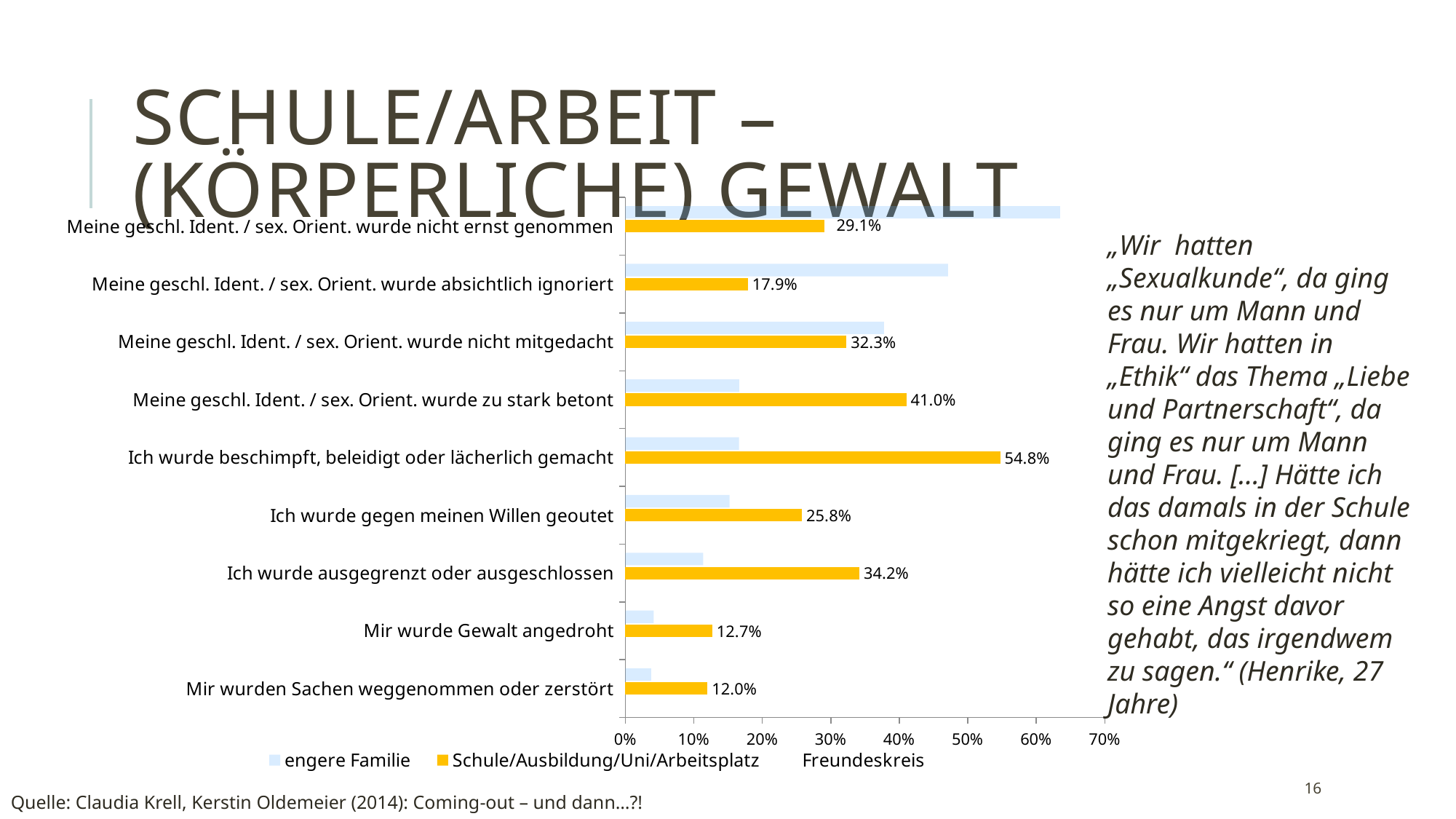
Is the 'engere Familie' value for 'Meine geschl. Ident. / sex. Orient. wurde nicht ernst genommen' greater or less than 60%? greater What is the value for 'Schule/Ausbildung/Uni/Arbeitsplatz' in the category 'Mir wurde Gewalt angedroht'? 12.7% Which category has the highest value for the 'Schule/Ausbildung/Uni/Arbeitsplatz' series? Ich wurde beschimpft, beleidigt oder lächerlich gemacht What kind of chart is shown on the slide? bar chart For the 'Schule/Ausbildung/Uni/Arbeitsplatz' series, which is larger: 'Ich wurde ausgegrenzt oder ausgeschlossen' or 'Ich wurde gegen meinen Willen geoutet'? Ich wurde ausgegrenzt oder ausgeschlossen What is the value for 'Schule/Ausbildung/Uni/Arbeitsplatz' in the category 'Meine geschl. Ident. / sex. Orient. wurde absichtlich ignoriert'? 17.9% Which category has the lowest value for the 'Schule/Ausbildung/Uni/Arbeitsplatz' series? Mir wurden Sachen weggenommen oder zerstört Is the 'engere Familie' value for 'Mir wurde Gewalt angedroht' greater or less than 10%? less What is the difference between the 'Schule/Ausbildung/Uni/Arbeitsplatz' values for 'Ich wurde beschimpft, beleidigt oder lächerlich gemacht' and 'Meine geschl. Ident. / sex. Orient. wurde zu stark betont'? 13.8 percentage points How many series does the legend list? 3 How many categories are shown on the chart? 9 What is the value for 'Schule/Ausbildung/Uni/Arbeitsplatz' in the category 'Ich wurde beschimpft, beleidigt oder lächerlich gemacht'? 54.8%